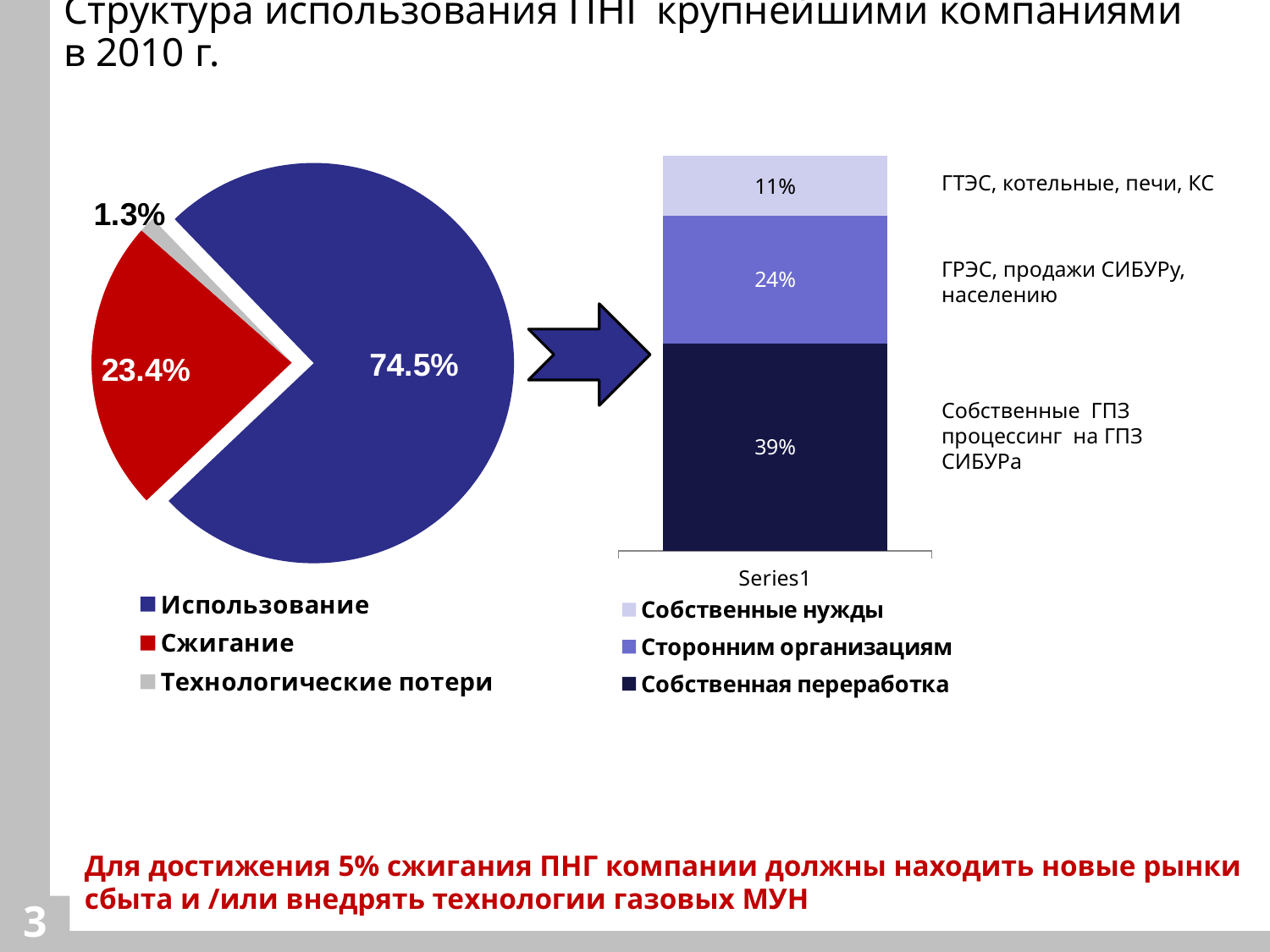
On the pie chart on the left, how many slices are there? 3 On the pie chart on the left, what share does Технологические потери have? 1.3% On the stacked bar chart on the right, what is the total of the three segments? 74% On the pie chart on the left, which category has the smallest slice? Технологические потери On the pie chart on the left, what share does Использование have? 74.5% On the pie chart on the left, what is the difference between the shares of Использование and Сжигание? 51.1% On the pie chart on the left, which category has the largest slice? Использование On the stacked bar chart on the right, how many series does the legend list? 3 On the stacked bar chart on the right, which segment is larger: Сторонним организациям or Собственные нужды? Сторонним организациям On the stacked bar chart on the right, what is the value for Собственная переработка? 39% On the pie chart on the left, what share does Сжигание have? 23.4% On the stacked bar chart on the right, what is the value for Собственные нужды? 11%